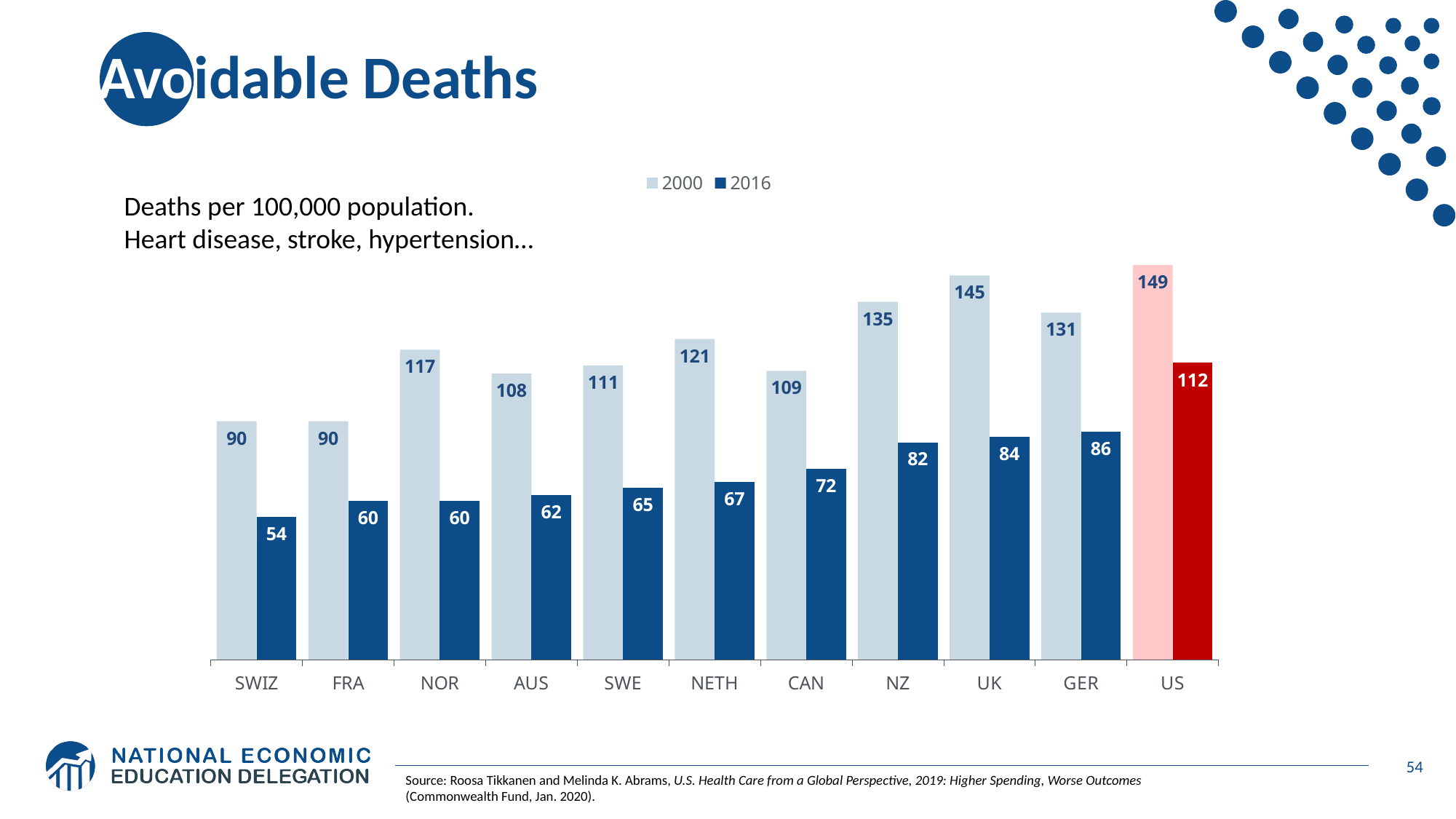
What is the difference between the US values for 2000 and 2016? 37 What is the total of the 2000 and 2016 values for Norway (NOR)? 177 Which is larger, the 2016 value for the UK or the 2016 value for Germany (GER)? GER What was the value for the US in 2016? 112 Which years are listed in the legend? 2000 and 2016 What was the value for Canada (CAN) in 2016? 72 How many series does the legend list? 2 What was the value for Switzerland (SWIZ) in 2000? 90 How many countries are shown on the x axis? 11 Which country had the highest value in 2000? US Which country had the lowest value in 2016? SWIZ What kind of chart is shown on the slide? Bar chart